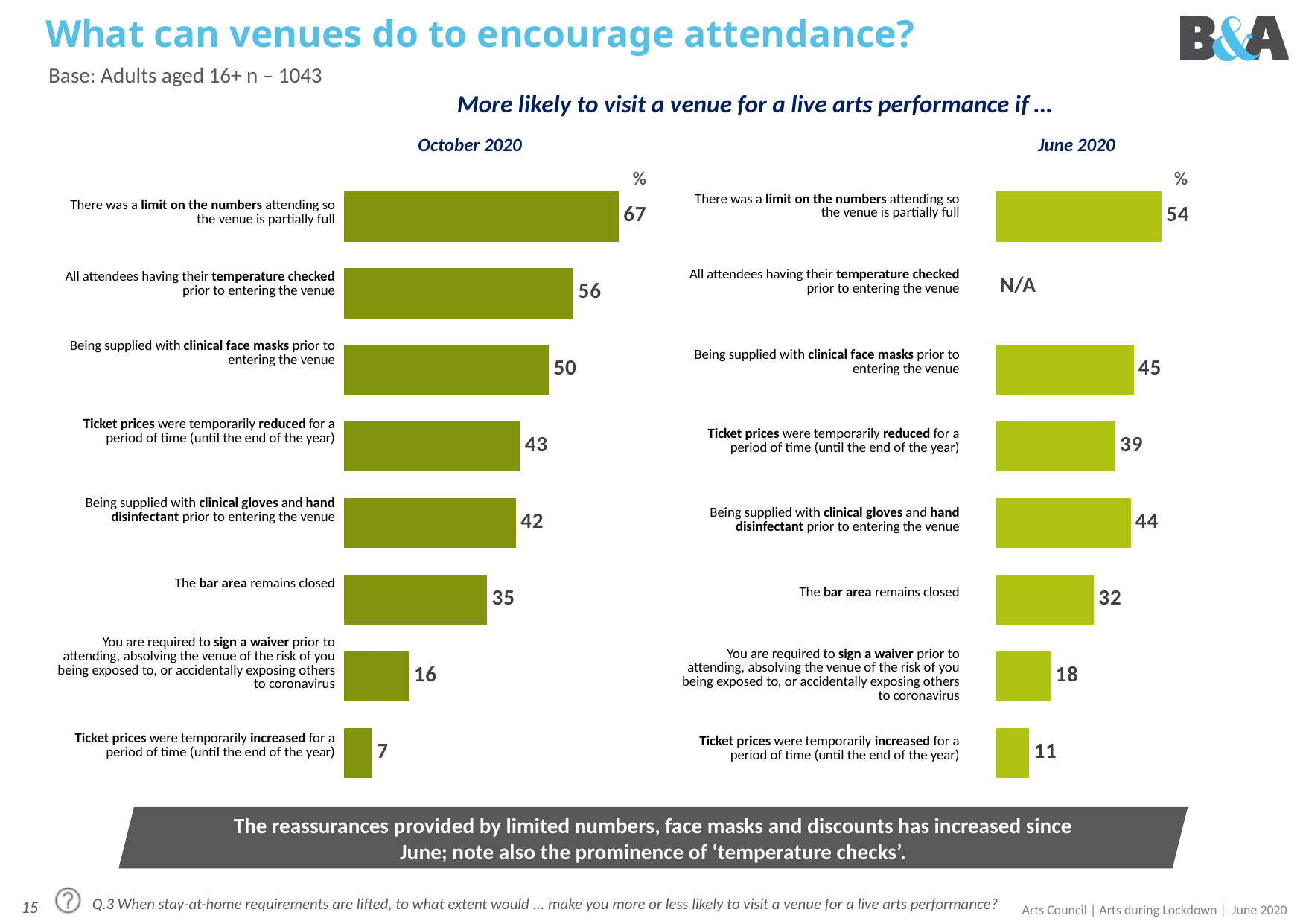
What type of chart is used on this slide? Bar chart How many options are listed in the October 2020 chart? 8 In the June 2020 chart, is the value for clinical gloves and hand disinfectant higher or lower than the value for ticket prices temporarily reduced? higher What is the difference between the October 2020 and June 2020 values for a limit on the numbers attending? 13 In the June 2020 chart, what is the value for being supplied with clinical face masks prior to entering the venue? 45 In the June 2020 chart, which option has the highest value? There was a limit on the numbers attending so the venue is partially full Is the value for the bar area remaining closed higher in the October 2020 chart or the June 2020 chart? October 2020 In the October 2020 chart, what is the value for all attendees having their temperature checked prior to entering the venue? 56 In the June 2020 chart, what is shown for all attendees having their temperature checked? N/A In the October 2020 chart, what is the difference between the values for ticket prices temporarily reduced and ticket prices temporarily increased? 36 In the October 2020 chart, what percentage said they would be more likely to visit if there was a limit on the numbers attending? 67 In the October 2020 chart, which option has the lowest value? Ticket prices were temporarily increased for a period of time